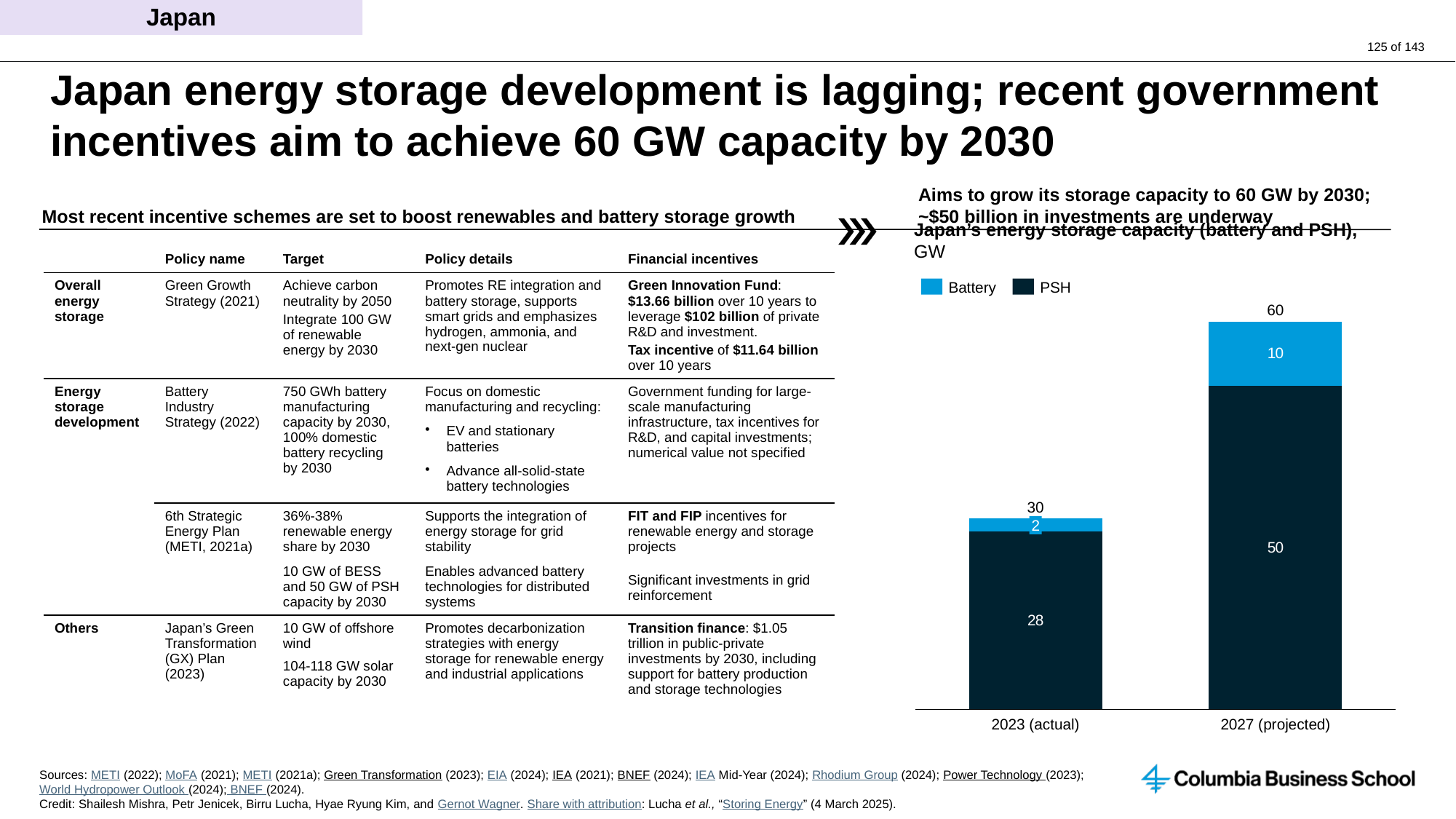
How many series does the legend list? 2 What is the Battery value for 2023 (actual)? 2 What is the total storage capacity shown for 2023 (actual)? 30 Which year has the larger Battery value, 2023 (actual) or 2027 (projected)? 2027 (projected) What is the PSH value for 2027 (projected)? 50 What is the total storage capacity shown for 2027 (projected)? 60 What is the Battery value for 2027 (projected)? 10 What is the difference between the PSH values for 2027 (projected) and 2023 (actual)? 22 What is the PSH value for 2023 (actual)? 28 What is the difference between the total for 2027 (projected) and the total for 2023 (actual)? 30 What kind of chart is shown on the slide? Stacked bar chart What unit is the chart's storage capacity measured in? GW